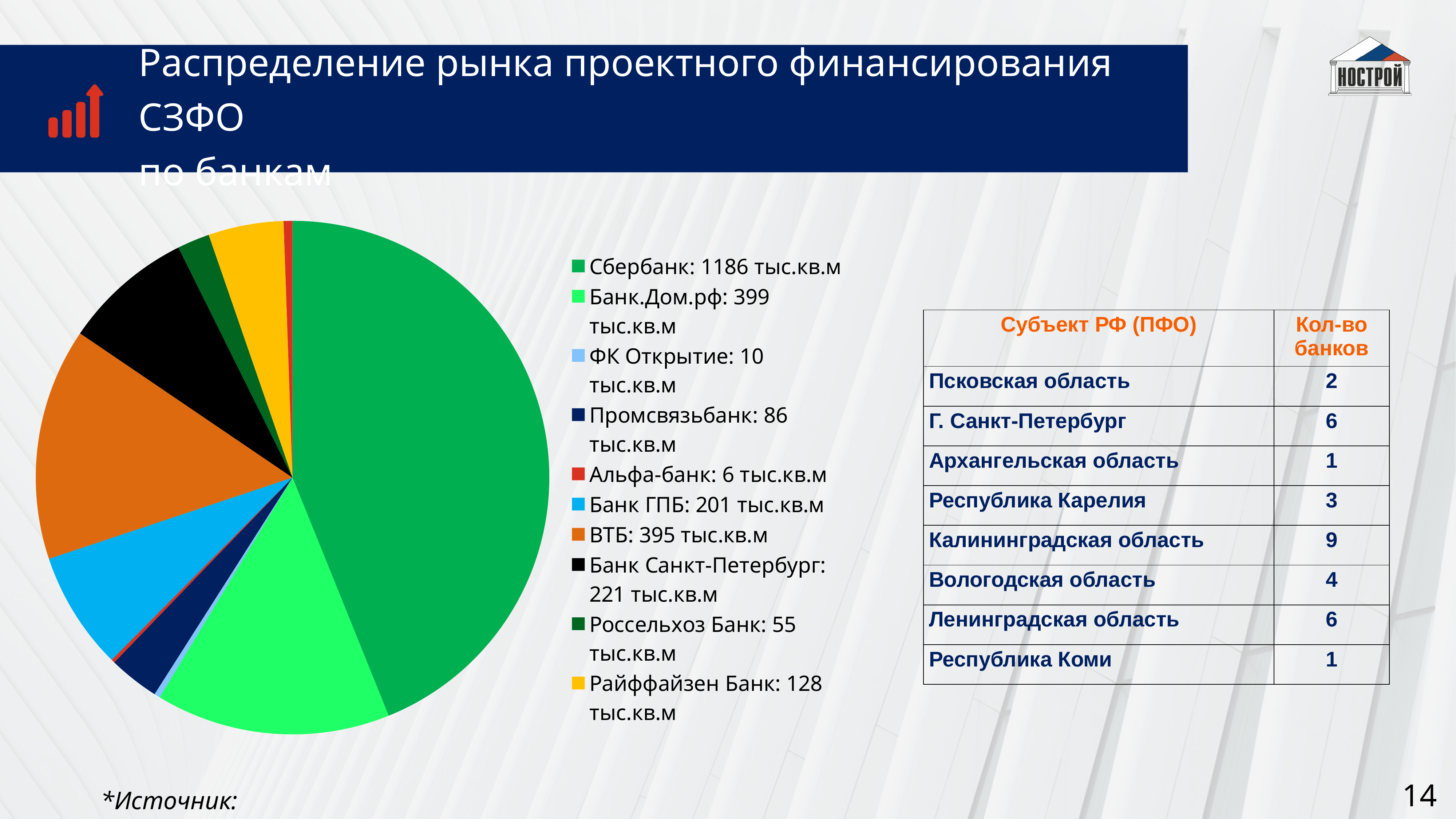
What is the difference between the values for Банк Санкт-Петербург and Банк ГПБ? 20 тыс.кв.м What is the value for ФК Открытие in the pie chart? 10 тыс.кв.м Which is larger in the pie chart: Промсвязьбанк or Россельхоз Банк? Промсвязьбанк Which bank has the largest share of the pie chart? Сбербанк What is the difference between the values for Сбербанк and Банк.Дом.рф? 787 тыс.кв.м What is the value for Райффайзен Банк in the pie chart? 128 тыс.кв.м What is the value for Сбербанк in the pie chart? 1186 тыс.кв.м What kind of chart is shown on the slide? Pie chart Which colour represents Сбербанк in the pie chart? Green Which bank has the smallest value in the pie chart? Альфа-банк What is the value for ВТБ in the pie chart? 395 тыс.кв.м